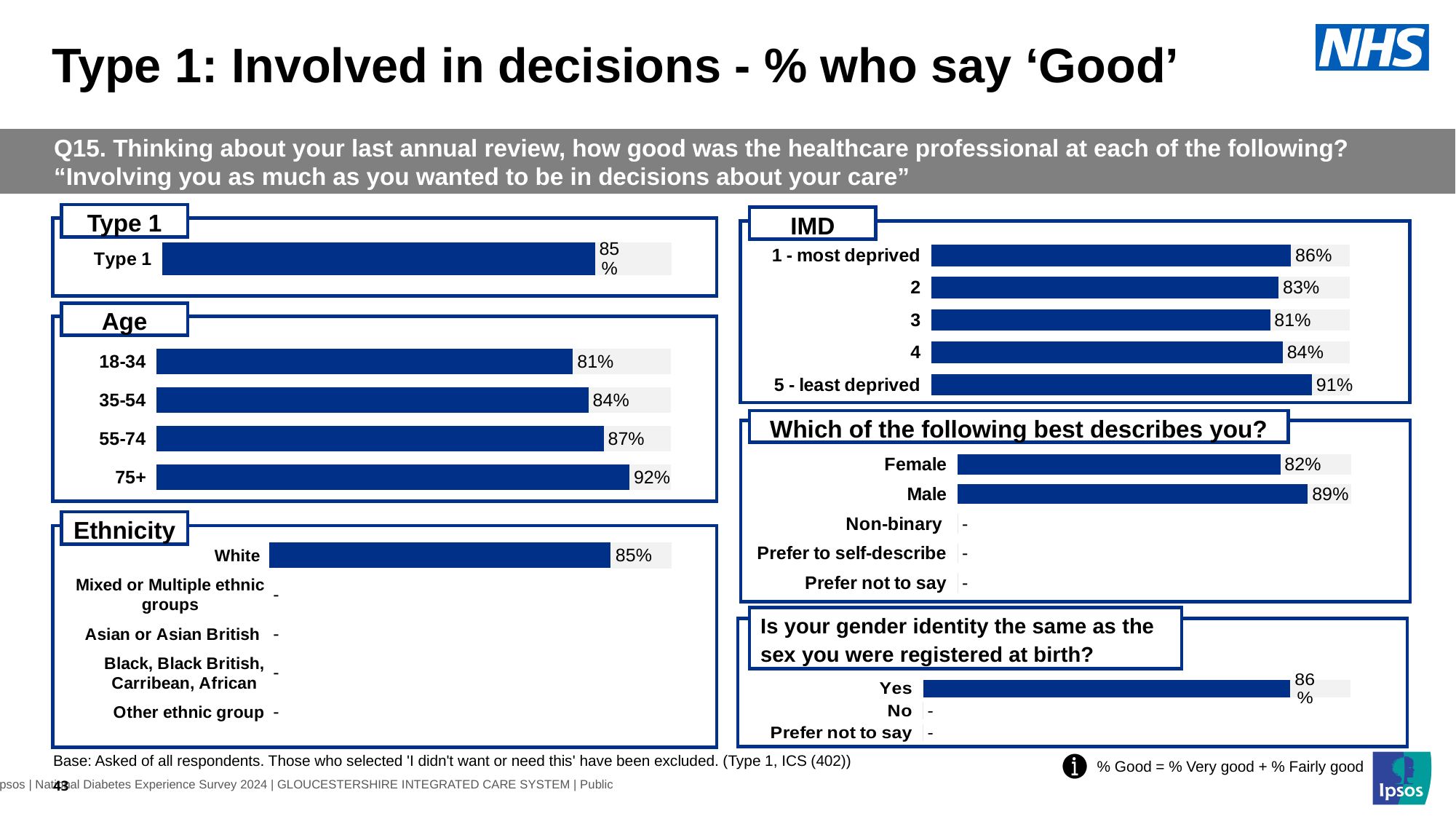
In the Age chart, which age group has the lowest value? 18-34 In the Age chart, what is the value for the 75+ group? 92% In the Ethnicity chart, what is the value for White? 85% What kind of chart is used in the IMD section? bar chart In the IMD chart, what is the value for category 3? 81% In the Type 1 chart, what is the value for Type 1? 85% In the Age chart, what is the difference between the 75+ and 18-34 values? 11 percentage points In the IMD chart, how many categories are shown? 5 In the Age chart, do the values rise or fall as age increases from 18-34 to 75+? rise In the 'Which of the following best describes you?' chart, what is the difference between Male and Female? 7 percentage points In the 'Which of the following best describes you?' chart, which is larger, Female or Male? Male In the IMD chart, which category has the highest value? 5 - least deprived